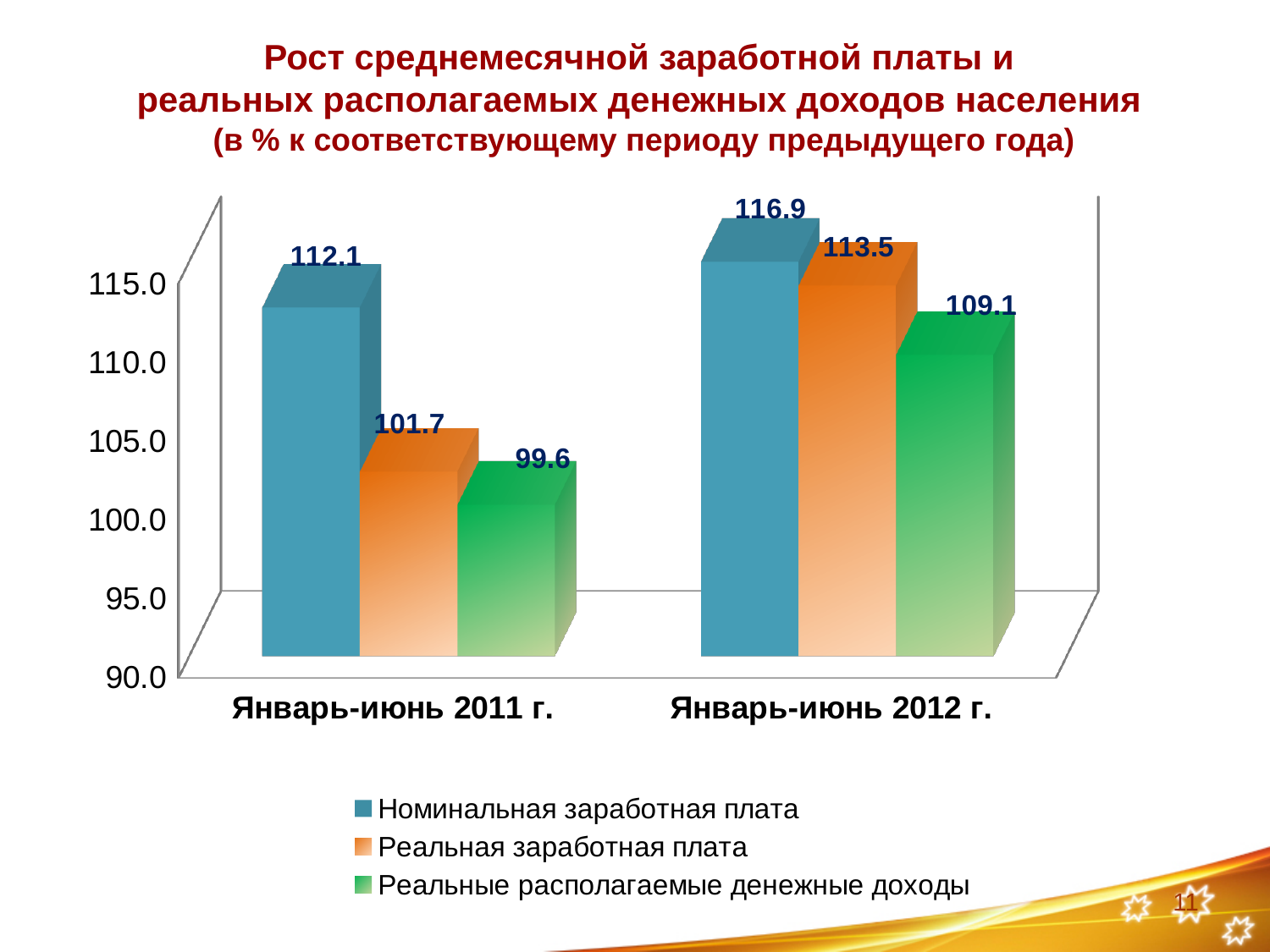
What is the difference between Номинальная заработная плата for Январь-июнь 2012 г. and for Январь-июнь 2011 г.? 4.8 What is the value of Номинальная заработная плата for Январь-июнь 2012 г.? 116.9 Is the value of Реальные располагаемые денежные доходы for Январь-июнь 2011 г. greater or less than 100.0? less What kind of chart is shown on the slide? bar chart Which series has the highest value for Январь-июнь 2011 г.? Номинальная заработная плата Which series has the lowest value for Январь-июнь 2012 г.? Реальные располагаемые денежные доходы Which is larger: Реальная заработная плата for Январь-июнь 2011 г. or Реальные располагаемые денежные доходы for Январь-июнь 2012 г.? Реальные располагаемые денежные доходы for Январь-июнь 2012 г. Does Реальная заработная плата rise or fall from Январь-июнь 2011 г. to Январь-июнь 2012 г.? rise How many series does the legend list? 3 What is the value of Реальные располагаемые денежные доходы for Январь-июнь 2011 г.? 99.6 How many categories are shown on the x axis? 2 What is the value of Реальная заработная плата for Январь-июнь 2012 г.? 113.5